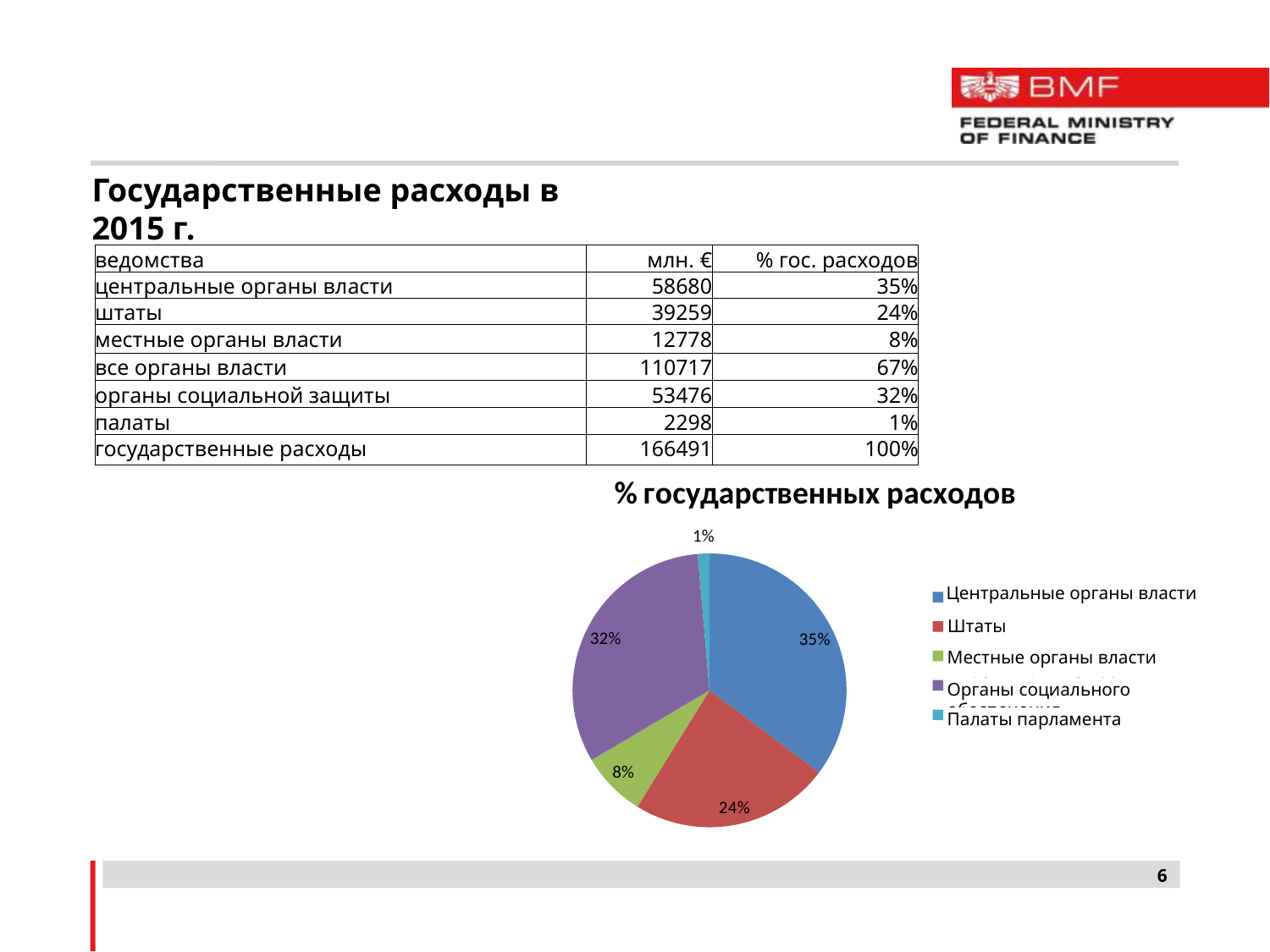
What share of the pie does Палаты парламента have? 1% What is the title of the pie chart? % государственных расходов What kind of chart is shown on the slide? pie chart Which slice is larger, Штаты or Местные органы власти? Штаты How many entries does the legend of the pie chart list? 5 What share of the pie does Штаты have? 24% What share of the pie does Центральные органы власти have? 35% What is the difference in percentage points between the Центральные органы власти slice and the Штаты slice? 11% Which slice of the pie chart is the smallest? Палаты парламента Which slice of the pie chart is the largest? Центральные органы власти How many slices does the pie chart have? 5